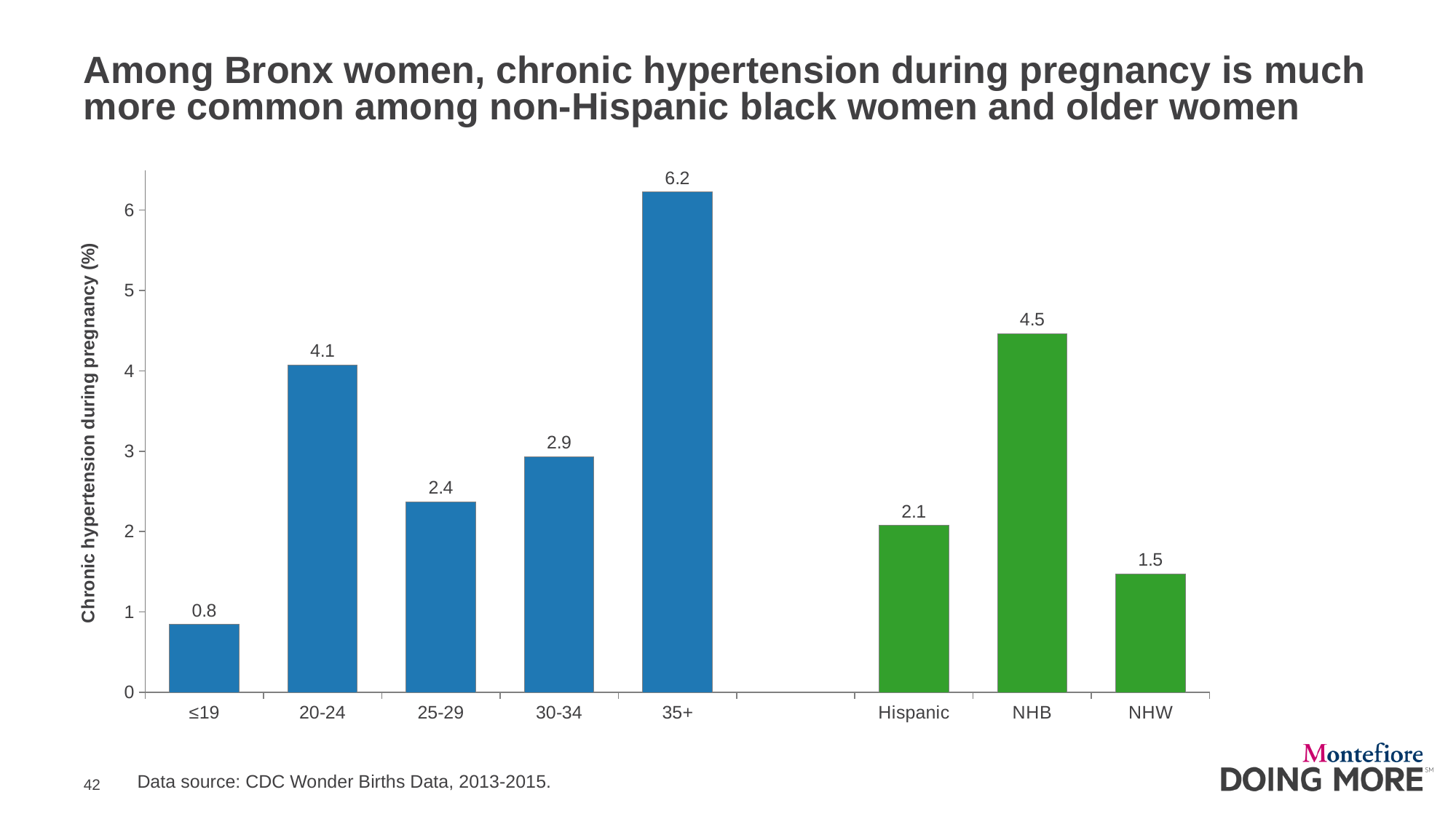
What is the value shown for women aged ≤19? 0.8 Which category has the lowest chronic hypertension rate? ≤19 What is the value shown for Hispanic women? 2.1 What is the value shown for NHB women? 4.5 Which category has the highest chronic hypertension rate? 35+ What is the difference between the values for NHB and NHW women? 3.0 What is the difference between the values for women aged 35+ and women aged 20-24? 2.1 How many categories are plotted on the chart? 8 What kind of chart is shown on the slide? Bar chart Which is larger, the value for women aged 25-29 or the value for Hispanic women? 25-29 What is the chronic hypertension during pregnancy rate for women aged 35+? 6.2 What is the label of the vertical axis? Chronic hypertension during pregnancy (%)